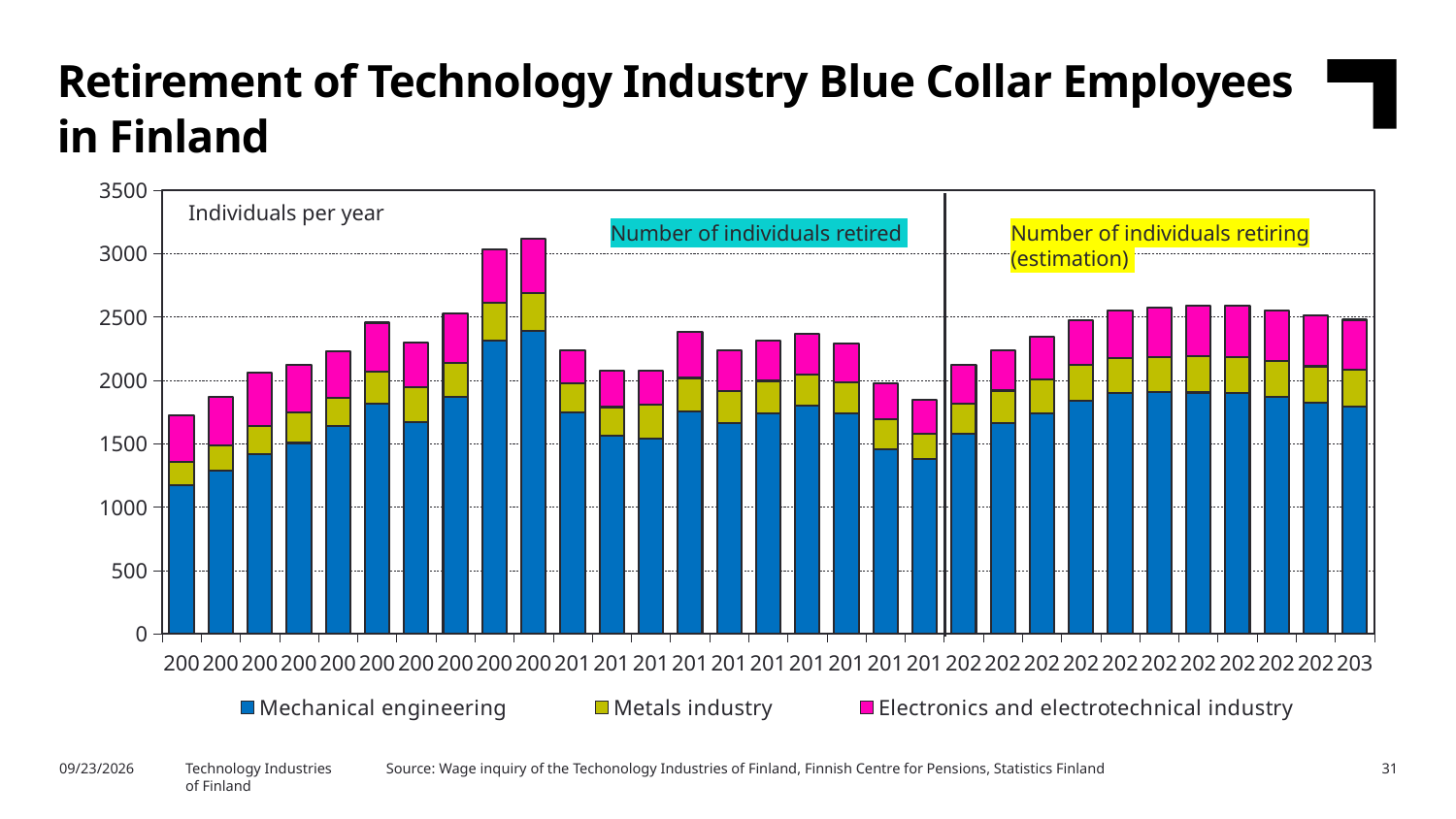
Is the total of the tallest bar greater or less than 3000? greater According to the annotation, what do the bars to the right of the vertical line represent? Number of individuals retiring (estimation) Is the Mechanical engineering segment of the leftmost bar greater or less than 1000? greater How many bars are plotted in the chart? 31 Is the total of the rightmost bar greater or less than 2000? greater How many series does the legend list? 3 Which series makes up the largest part of every bar? Mechanical engineering What is the title of the slide's chart? Retirement of Technology Industry Blue Collar Employees in Finland What kind of chart is shown on the slide? Stacked bar chart